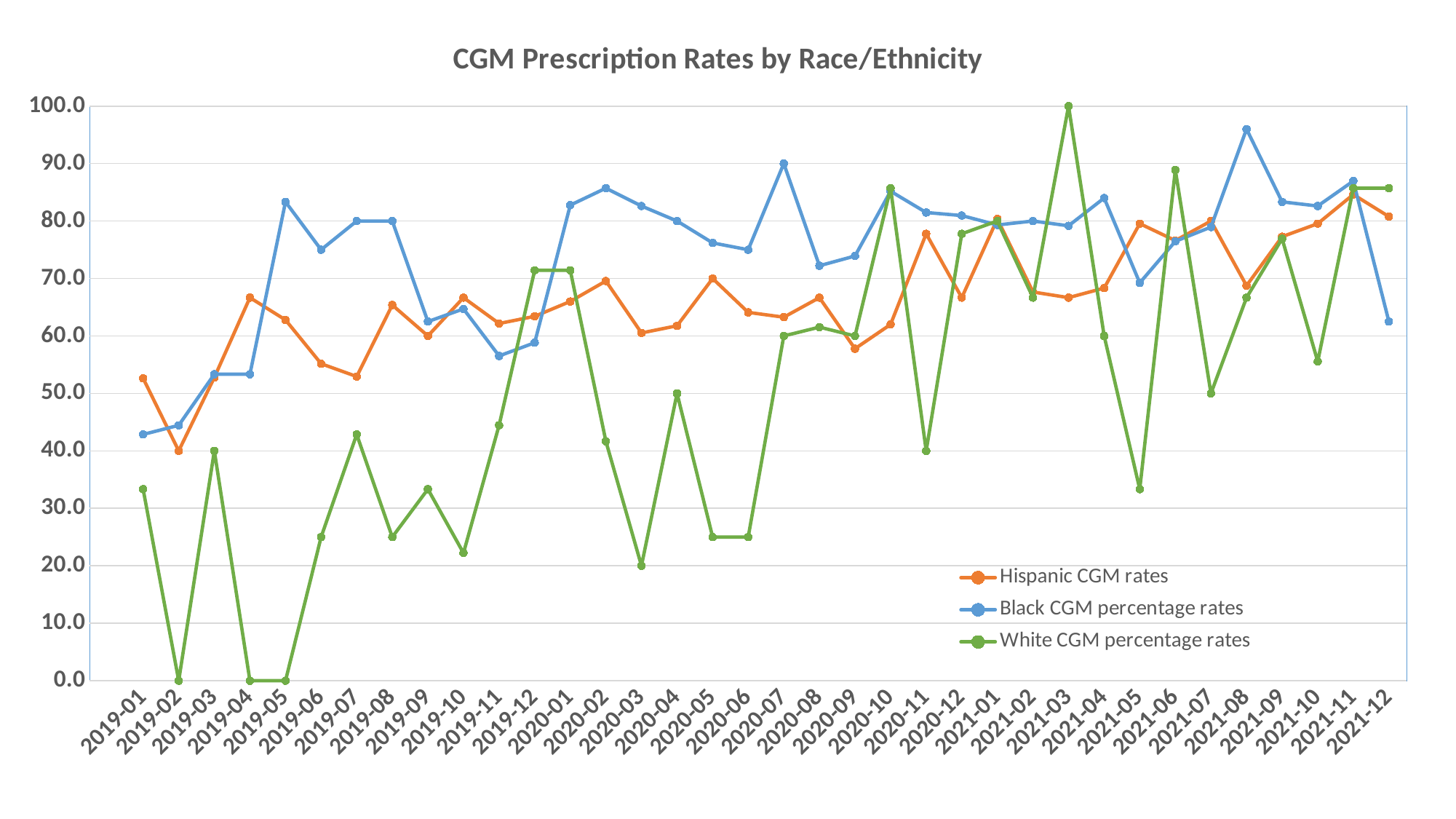
In which month does the White CGM percentage rate reach its highest value? 2021-03 What is the White CGM percentage rate for 2019-02? 0.0 What is the White CGM percentage rate for 2021-03? 100.0 In which month does the Black CGM percentage rate reach its highest value? 2021-08 Overall, do the Hispanic CGM rates rise or fall from 2019-01 to 2021-12? rise How many months are plotted along the x axis? 36 What kind of chart is shown on the slide? line chart In 2020-07, which series has the higher value: Black CGM percentage rates or Hispanic CGM rates? Black CGM percentage rates How many series does the legend list? 3 Is the White CGM percentage rate for 2019-06 greater or less than 30.0? less In which month is the Hispanic CGM rate at its lowest? 2019-02 Is the Black CGM percentage rate for 2021-08 greater or less than 90.0? greater